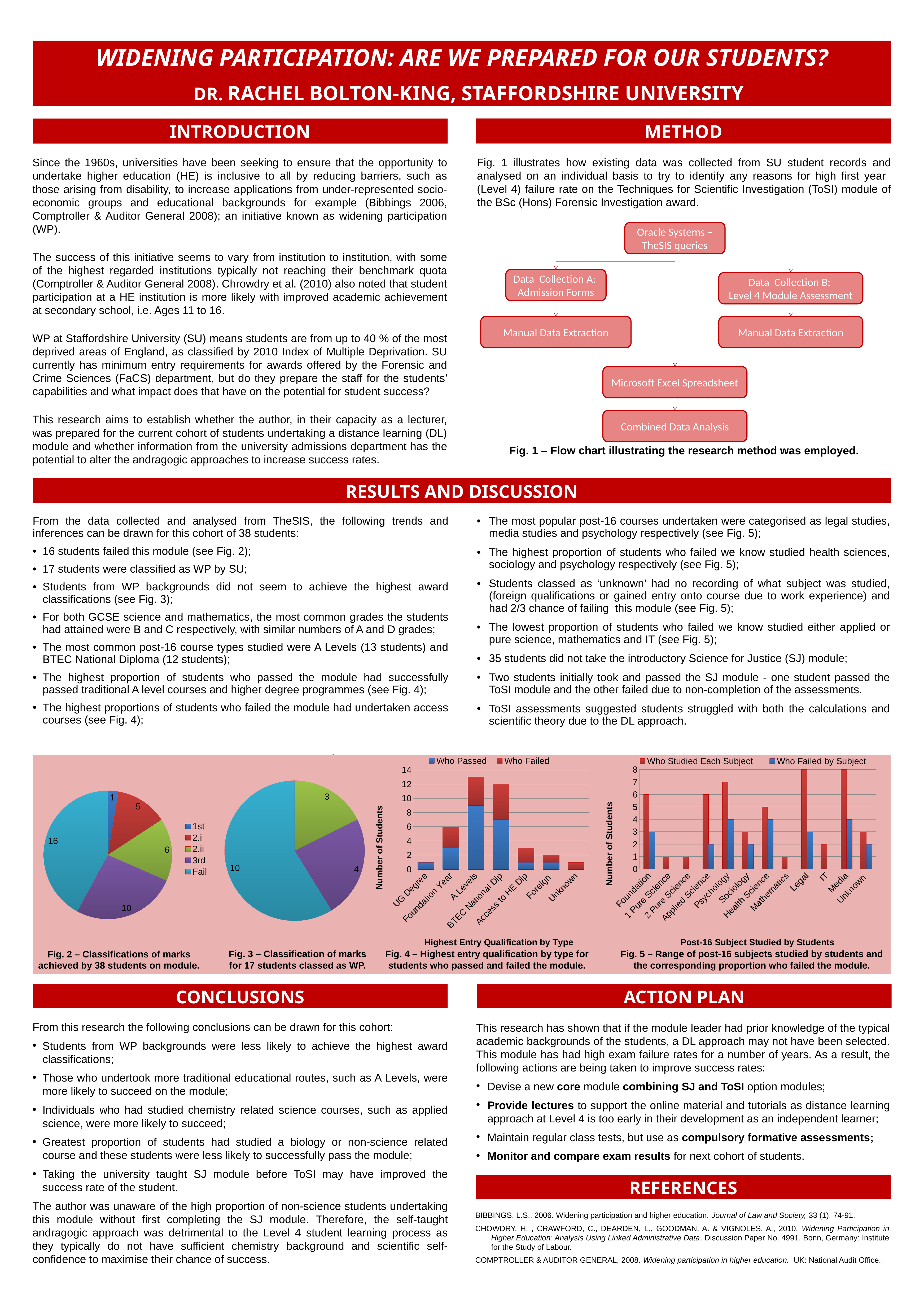
In Fig. 5 (post-16 subject studied by students), how many subject categories are shown on the x axis? 12 In Fig. 3 (classification of marks for 17 students classed as WP), what is the value of the largest slice? 10 In Fig. 2 (classifications of marks achieved by 38 students), which classification has the smallest slice? 1st In Fig. 2 (classifications of marks achieved by 38 students), how many more students are in Fail than in 3rd? 6 In Fig. 5 (post-16 subject studied by students), is the 'Who Studied Each Subject' value for Legal greater or less than 6? greater In Fig. 2 (classifications of marks achieved by 38 students), how many students are in the Fail category? 16 In Fig. 4 (highest entry qualification by type), how many series does the legend list? 2 What type of chart is Fig. 3 (classification of marks for 17 students classed as WP)? pie chart In Fig. 2 (classifications of marks achieved by 38 students), which classification has the largest slice? Fail In Fig. 4 (highest entry qualification by type), which qualification has the tallest stacked bar? A Levels In Fig. 2 (classifications of marks achieved by 38 students), how many classification categories does the legend list? 5 In Fig. 4 (highest entry qualification by type), how many qualification categories are shown on the x axis? 7